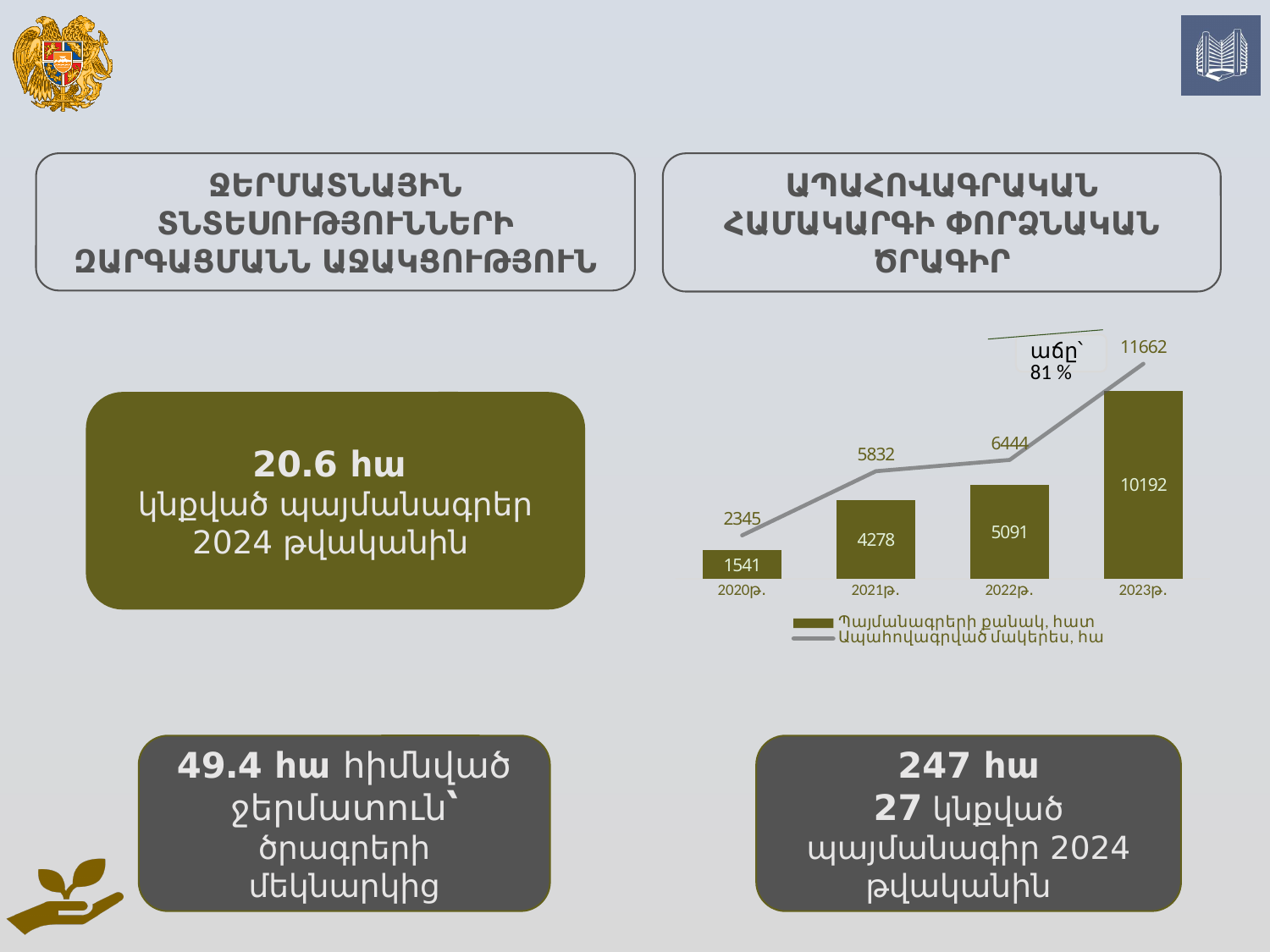
Which year has the highest number of contracts? 2023թ. What is the number of contracts shown for 2020թ.? 1541 What is the difference in insured area between 2021թ. and 2020թ.? 3487 Do the number of contracts rise or fall from 2020թ. to 2023թ.? rise Which is larger: the number of contracts in 2021թ. or in 2022թ.? 2022թ. How many years are shown on the x axis of the chart? 4 How many series does the chart legend list? 2 Which year has the lowest insured area? 2020թ. What is the difference in the number of contracts between 2023թ. and 2022թ.? 5101 What is the insured area (Ապահովագրված մակերես, հա) shown for 2021թ.? 5832 What is the number of contracts (Պայմանագրերի քանակ, հատ) shown for 2023թ.? 10192 What is the insured area value shown for 2022թ.? 6444